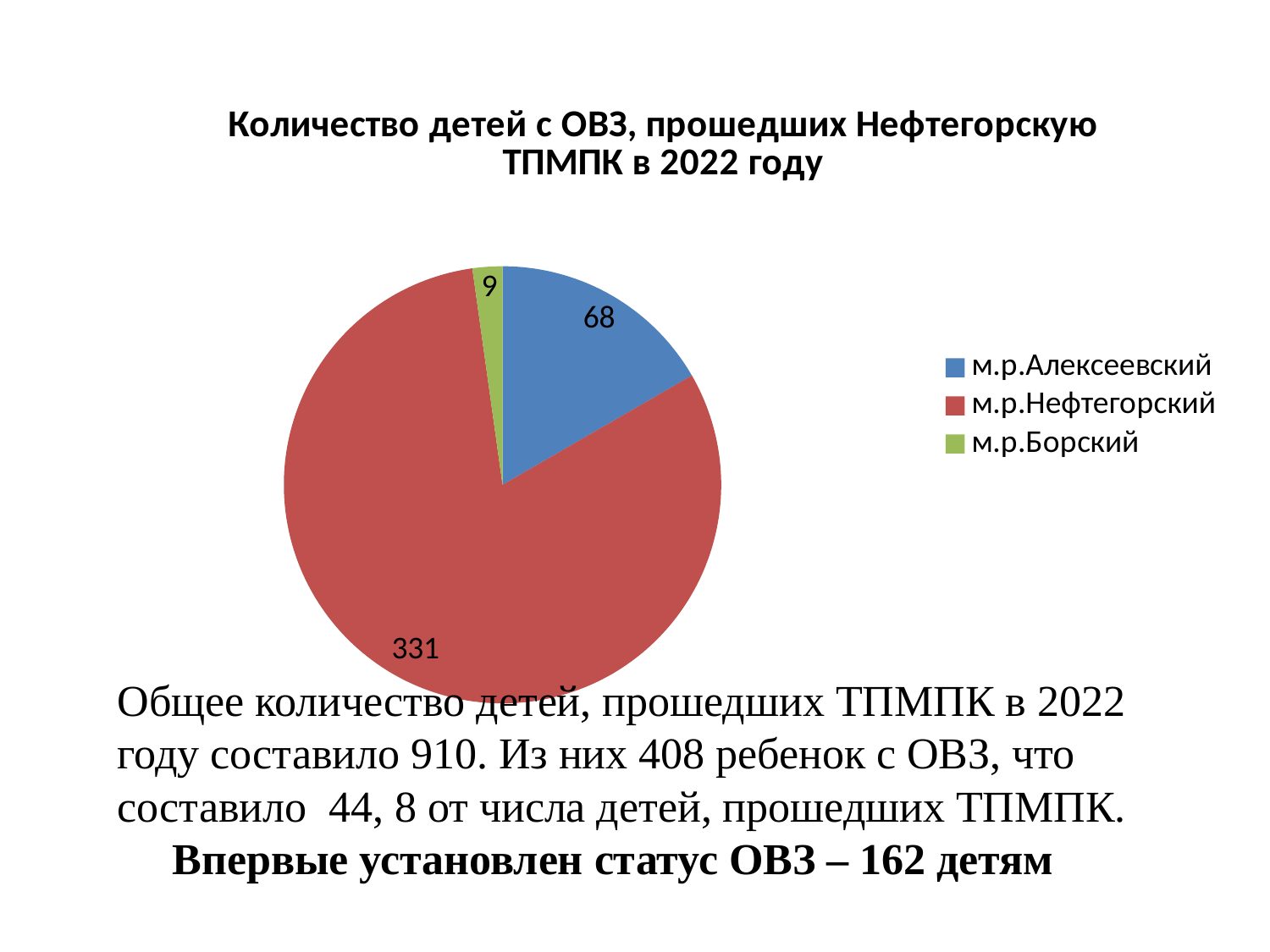
Which category has the smallest slice in the pie chart? м.р.Борский What is the title of the chart? Количество детей с ОВЗ, прошедших Нефтегорскую ТПМПК в 2022 году How many categories are shown in the pie chart? 3 Which is larger, the value for м.р.Алексеевский or the value for м.р.Борский? м.р.Алексеевский What is the value for м.р.Алексеевский in the pie chart? 68 What is the total of all slices in the pie chart? 408 What is the difference between the values for м.р.Нефтегорский and м.р.Алексеевский? 263 What kind of chart is shown on the slide? pie chart Which category has the largest slice in the pie chart? м.р.Нефтегорский What is the difference between the values for м.р.Алексеевский and м.р.Борский? 59 What is the value for м.р.Борский in the pie chart? 9 What is the value for м.р.Нефтегорский in the pie chart? 331